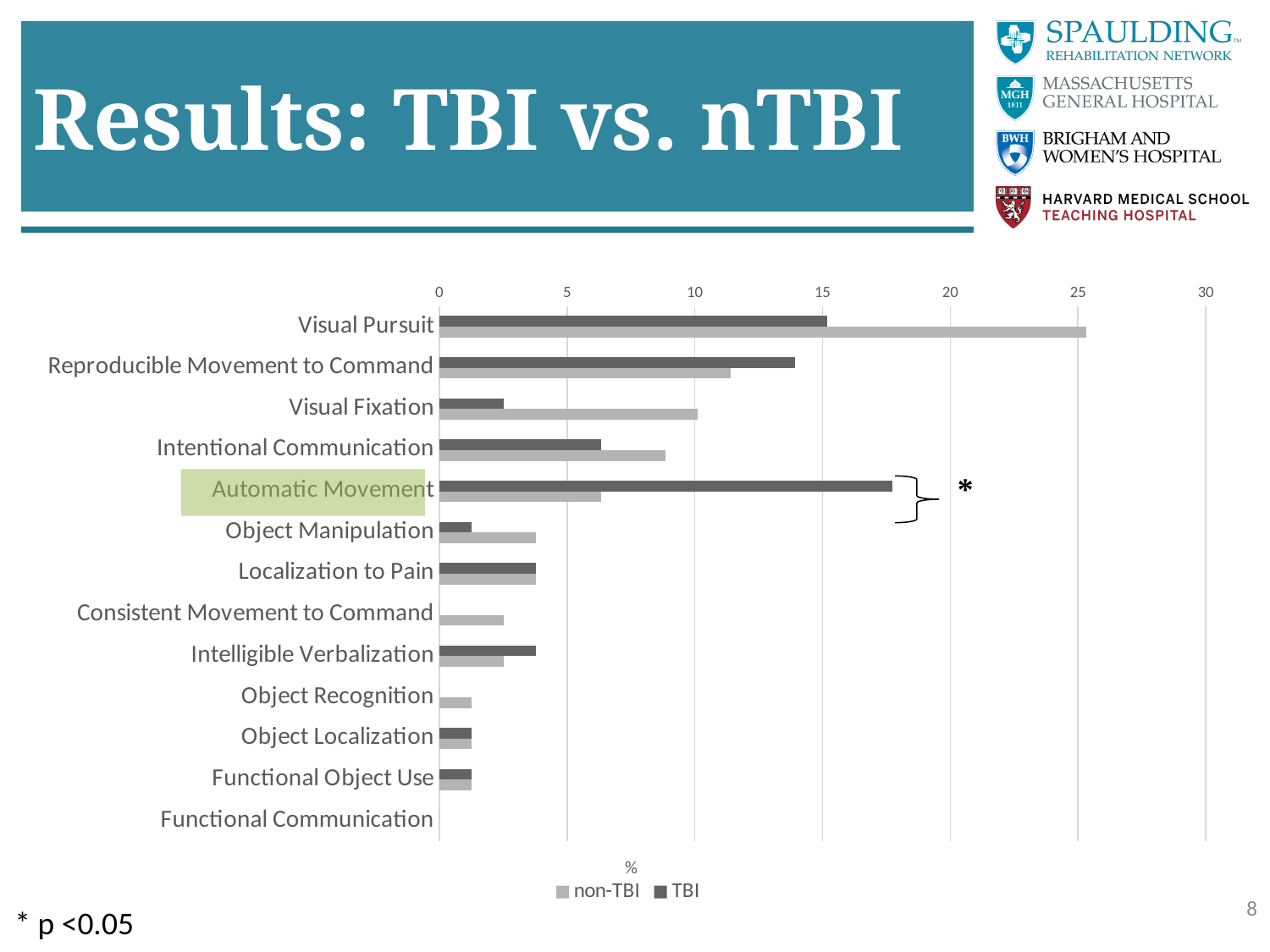
For Visual Fixation, which series has the larger value, TBI or non-TBI? non-TBI What kind of chart is shown on the slide? bar chart How many series does the legend list? 2 Is the TBI value for Automatic Movement greater or less than 15? greater Which category has the highest TBI value? Automatic Movement Which category is highlighted with a green box on the chart? Automatic Movement What does the asterisk next to the chart indicate, according to the footnote? p <0.05 How many categories are plotted on the chart? 13 For Automatic Movement, which series has the larger value, TBI or non-TBI? TBI Which category has the highest non-TBI value? Visual Pursuit